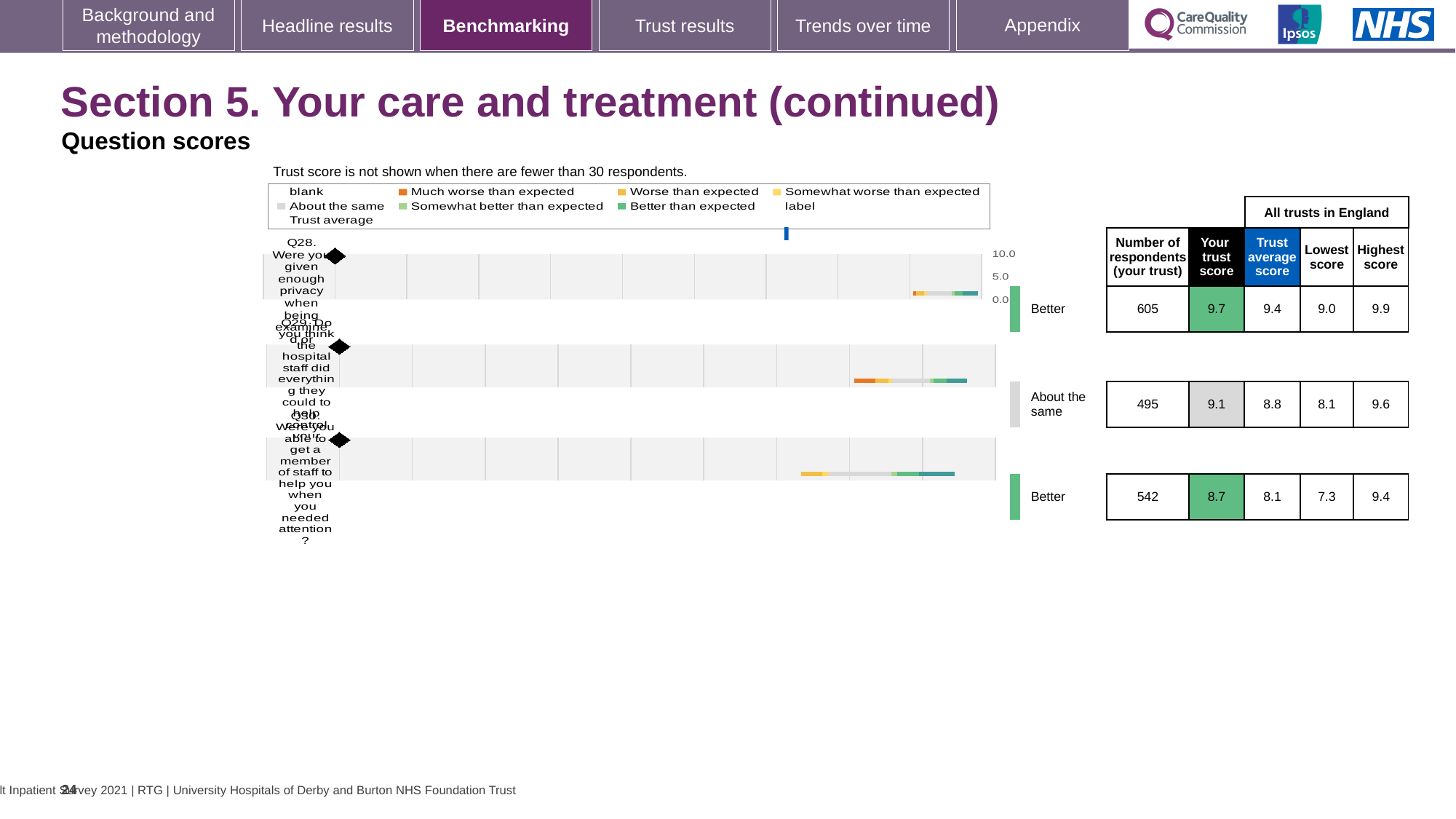
Is the trust score for Q29 larger or smaller than the trust score for Q28? smaller What kind of chart is used to show the question scores on this slide? bar chart What is the highest score across all trusts in England for Q29? 9.6 How many respondents answered Q28? 605 Which of the three questions has the lowest trust score? Q30 How many questions (categories) are plotted in the question scores chart? 3 What is the benchmark category shown for Q29? About the same What is the trust score for Q30 (Were you able to get a member of staff to help you when you needed attention)? 8.7 What is the trust score for Q29 (Do you think the hospital staff did everything they could to help control your pain)? 9.1 What is the difference between the trust score and the trust average score for Q30? 0.6 What is the trust score for Q28 (Were you given enough privacy when being examined or treated)? 9.7 Which of the three questions has the highest trust score? Q28